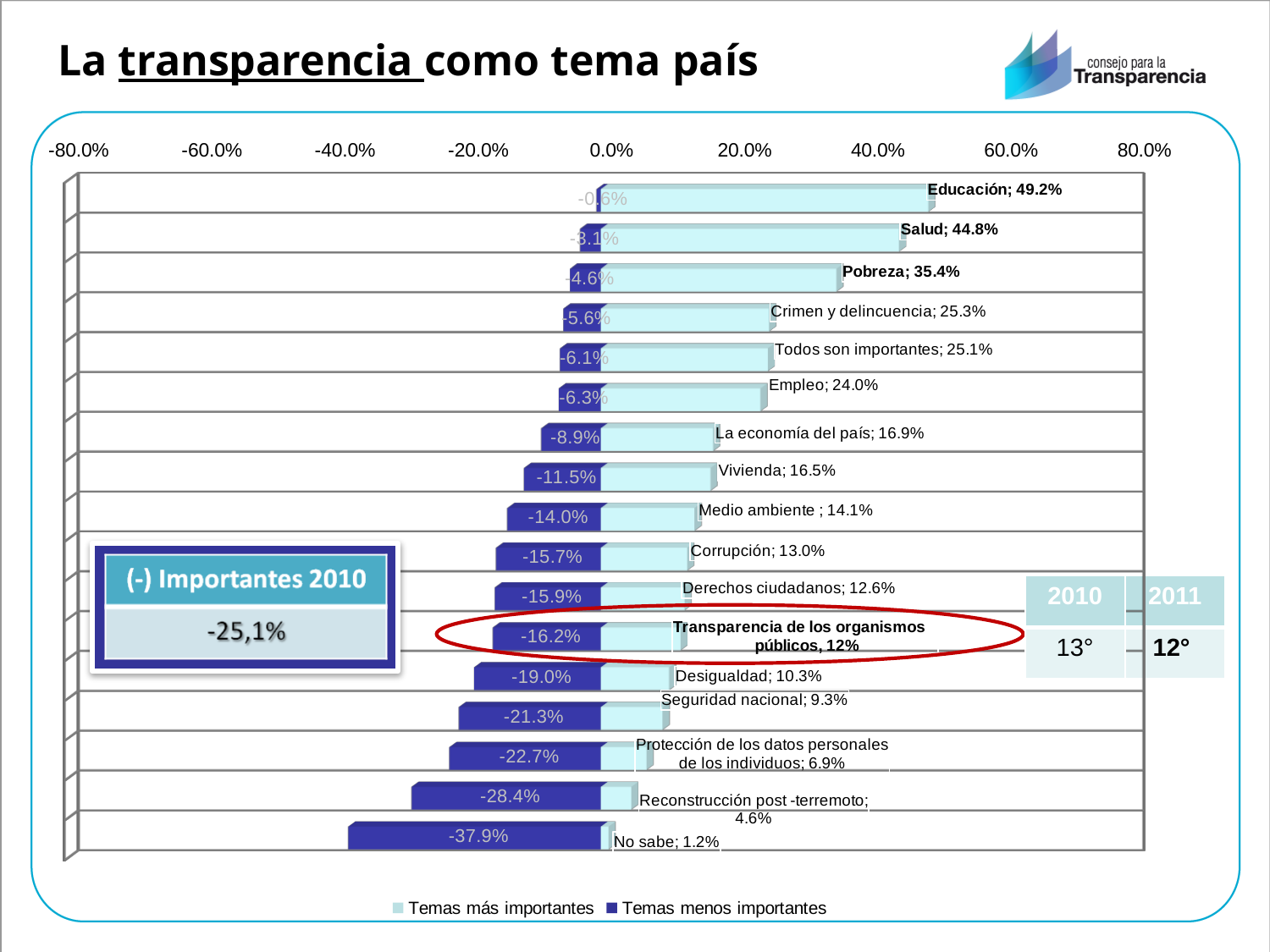
What kind of chart is shown on the slide? Bar chart What is the 'Temas más importantes' value for Transparencia de los organismos públicos? 12% What is the value for Educación in the 'Temas más importantes' series? 49.2% How many series does the legend list? 2 Which has a larger 'Temas más importantes' value, Crimen y delincuencia or Empleo? Crimen y delincuencia Which category has the lowest 'Temas más importantes' value? No sabe What is the 'Temas menos importantes' value for the bar labelled No sabe? -37.9% How many categories are plotted in the chart? 17 Which category has the highest 'Temas más importantes' value? Educación What is the difference between the 'Temas más importantes' values for Educación and Salud? 4.4% What is the value for Salud in the 'Temas más importantes' series? 44.8% Which series is shown in dark blue according to the legend? Temas menos importantes